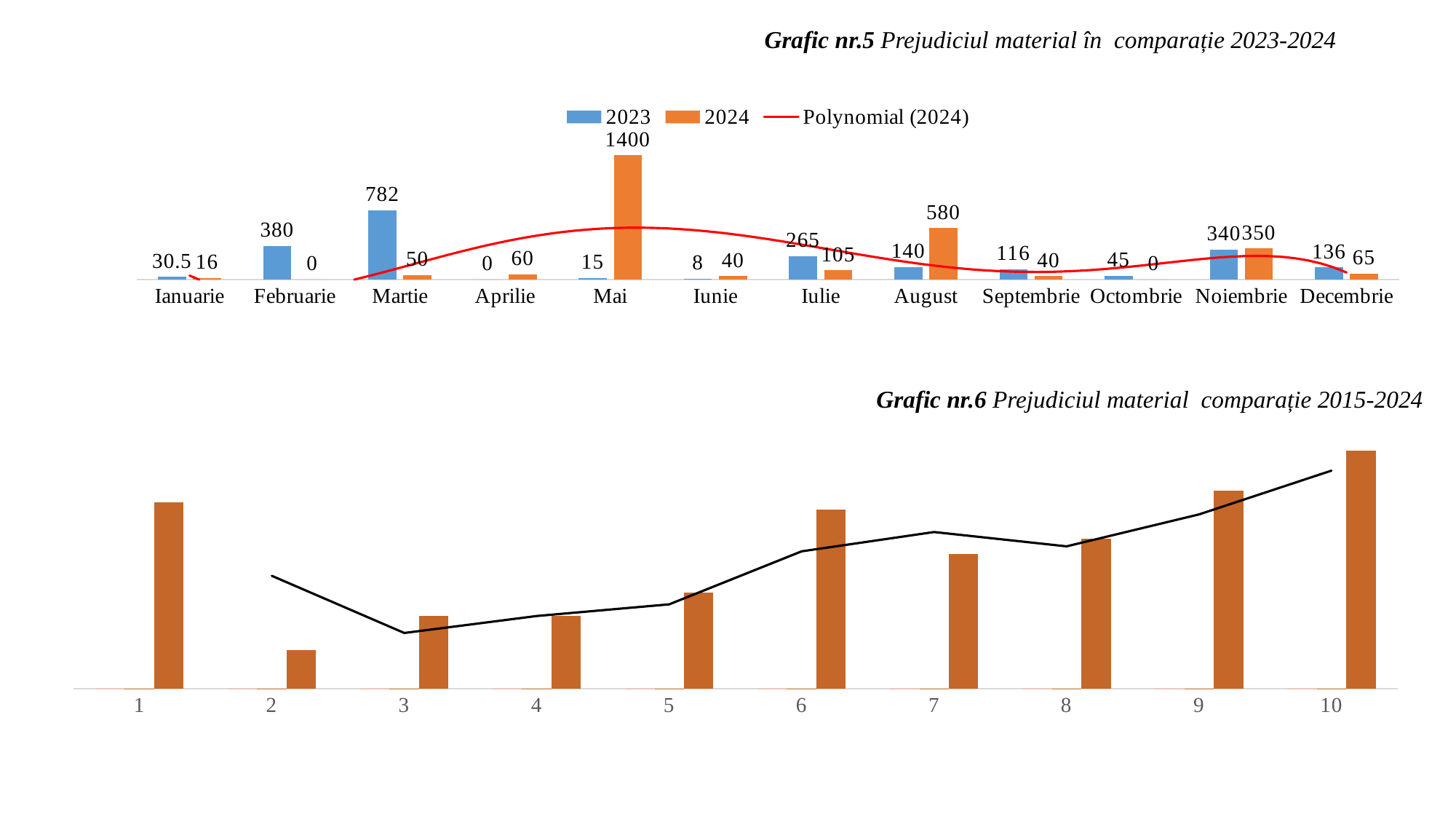
In Grafic nr.5, what is the difference between the 2024 and 2023 values for August? 440 In Grafic nr.6, how many bars are shown? 10 In Grafic nr.5, which is larger for Noiembrie: the 2023 value or the 2024 value? 2024 What kind of chart is Grafic nr.6? Bar chart In Grafic nr.5, how many entries does the legend list? 3 In Grafic nr.5, what is the 2023 value for Martie? 782 In Grafic nr.5, how many months are shown on the x axis? 12 In Grafic nr.5, which month has the highest 2023 value? Martie In Grafic nr.5, what is the 2023 value for Ianuarie? 30.5 In Grafic nr.6, which category has the lowest bar? 2 In Grafic nr.5, which month has the highest 2024 value? Mai In Grafic nr.5, what is the 2024 value for Mai? 1400